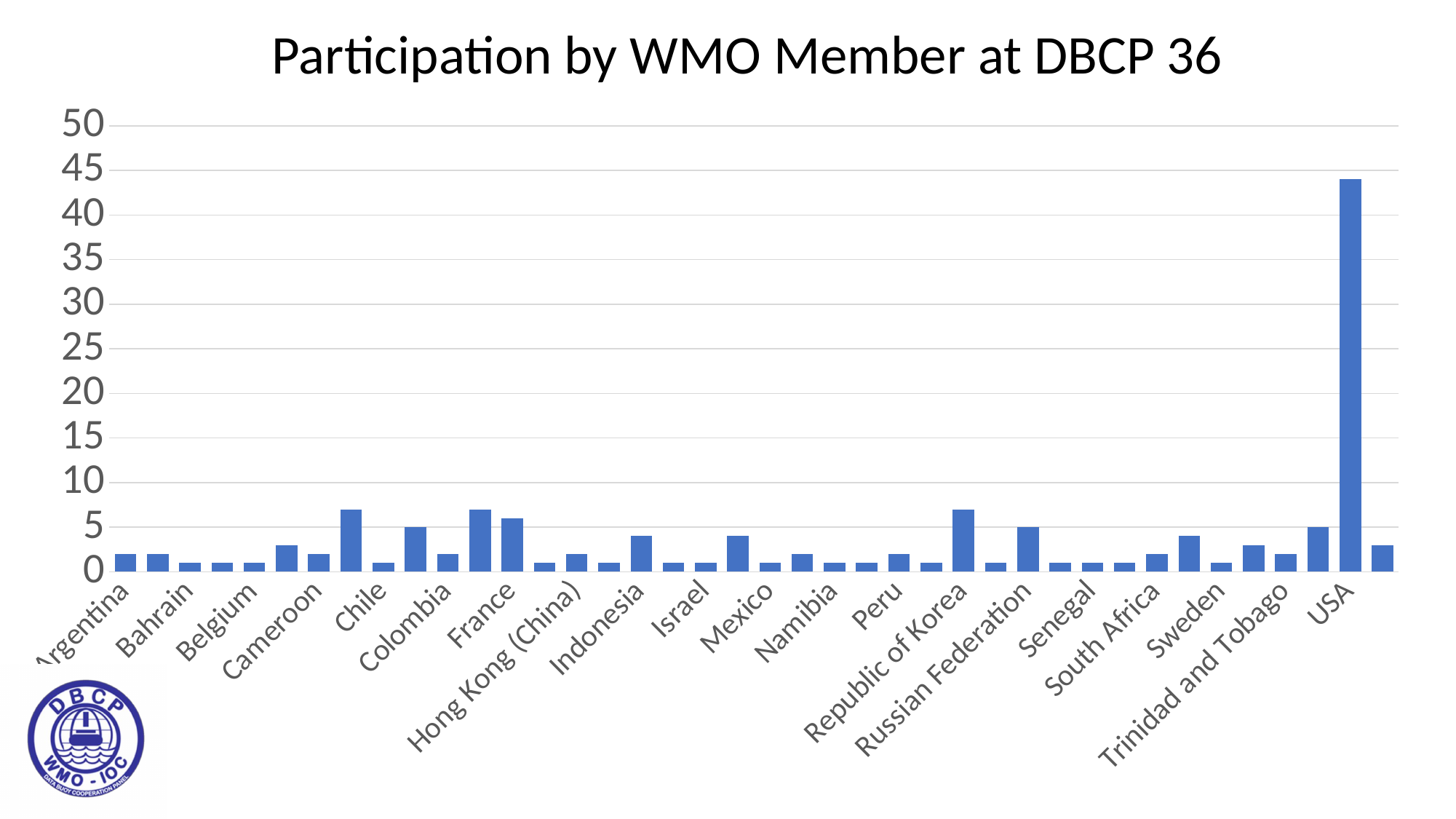
What kind of chart is shown on the slide? bar chart Is the value for USA greater or less than 45? less Is the value for Cameroon greater or less than 5? less Which has the larger value, USA or Republic of Korea? USA Which has the larger value, Republic of Korea or Chile? Republic of Korea What colour are the bars in the chart? blue Which WMO Member has the highest participation in the chart? USA Is the value for USA greater or less than 40? greater What is the title of the chart? Participation by WMO Member at DBCP 36